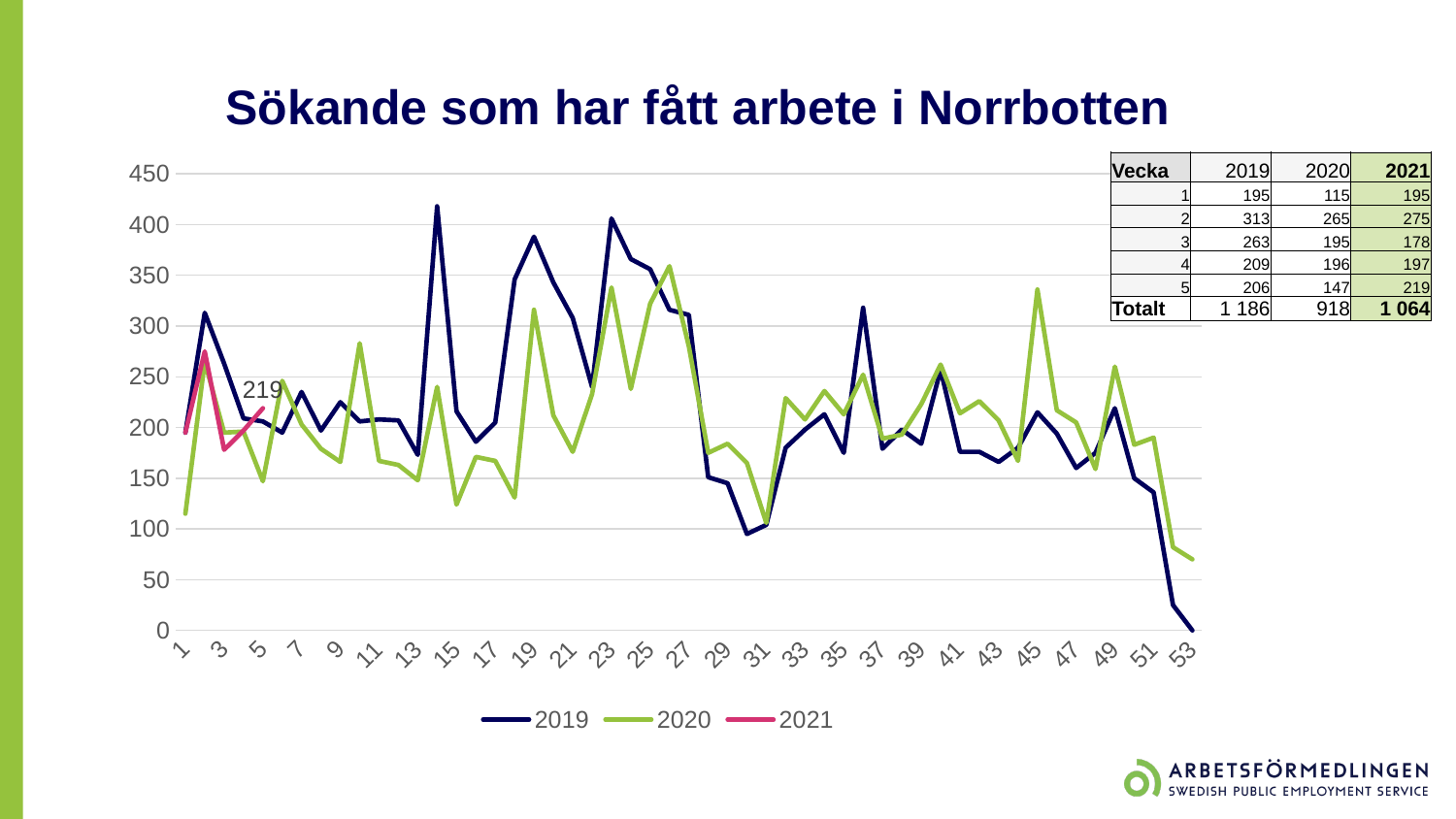
Is the value for 2019 at week 53 greater or less than 50? less According to the table, what is the value for 2019 in week 2? 313 How many series does the legend list? 3 What is the title of the chart? Sökande som har fått arbete i Norrbotten According to the table, what is the total (Totalt) for 2021? 1 064 Which year has the highest total (Totalt) in the table? 2019 What is the difference between the 2019 and 2020 values in week 1 according to the table? 80 What value is labelled on the 2021 line at week 5? 219 Does the 2019 line rise or fall from week 49 to week 53? fall What kind of chart is shown on the slide? line chart Is the peak value of the 2019 line around week 14 greater or less than 400? greater Which is larger in week 2, the 2019 value or the 2020 value? 2019